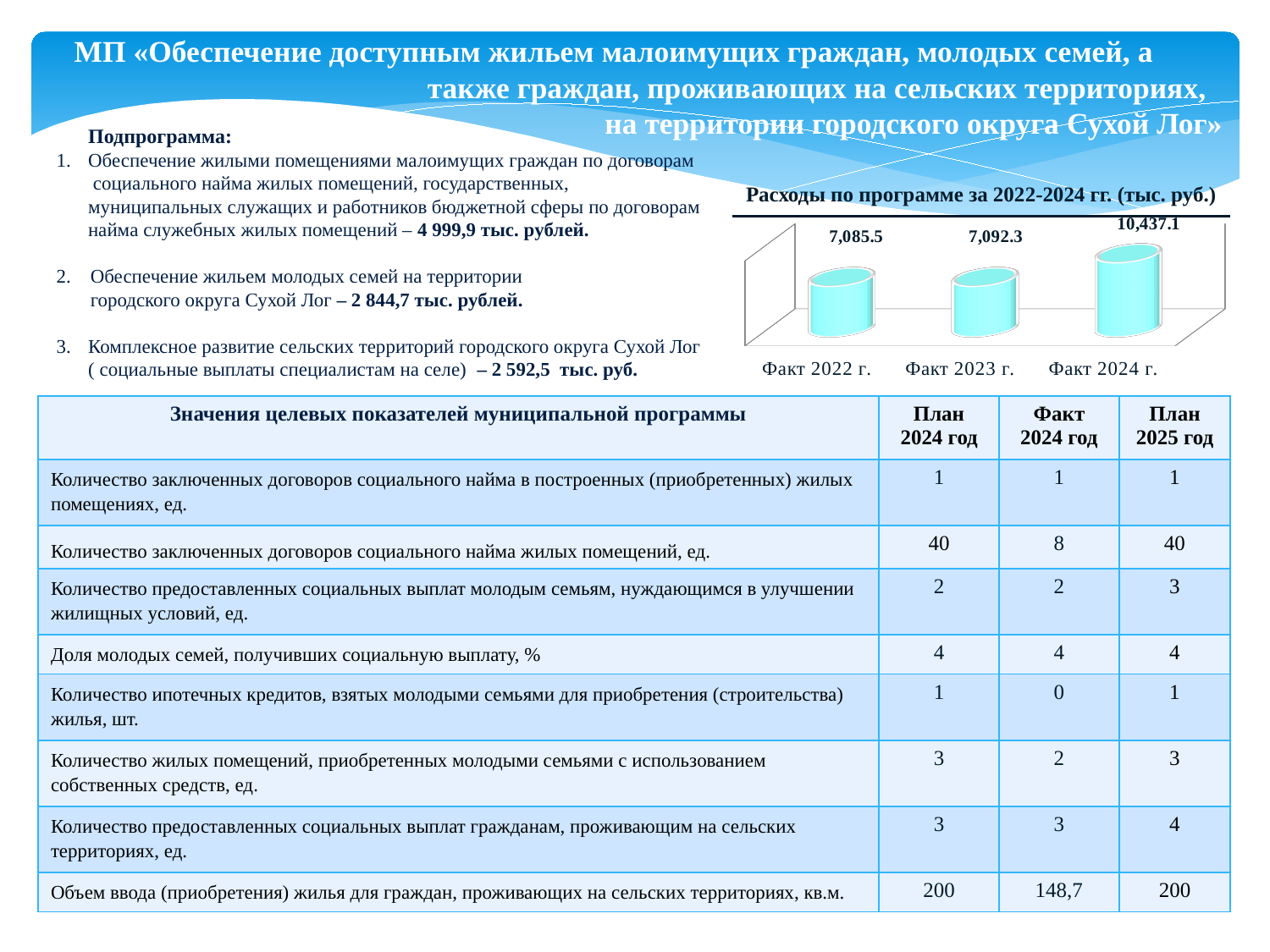
What is the value for Факт 2023 г. in the chart «Расходы по программе за 2022-2024 гг. (тыс. руб.)»? 7,092.3 Which category has the lowest value in the chart «Расходы по программе за 2022-2024 гг. (тыс. руб.)»? Факт 2022 г. Which category has the highest value in the chart «Расходы по программе за 2022-2024 гг. (тыс. руб.)»? Факт 2024 г. In what units are the values of the chart «Расходы по программе за 2022-2024 гг.» given, according to its title? тыс. руб. How many categories are shown in the chart «Расходы по программе за 2022-2024 гг. (тыс. руб.)»? 3 In the chart «Расходы по программе за 2022-2024 гг. (тыс. руб.)», what is the difference between the values for Факт 2024 г. and Факт 2022 г.? 3,351.6 Do the values in the chart «Расходы по программе за 2022-2024 гг. (тыс. руб.)» rise or fall from Факт 2022 г. to Факт 2024 г.? Rise What kind of chart is «Расходы по программе за 2022-2024 гг. (тыс. руб.)»? Bar chart What is the value for Факт 2022 г. in the chart «Расходы по программе за 2022-2024 гг. (тыс. руб.)»? 7,085.5 In the chart «Расходы по программе за 2022-2024 гг. (тыс. руб.)», what is the difference between the values for Факт 2024 г. and Факт 2023 г.? 3,344.8 What is the value for Факт 2024 г. in the chart «Расходы по программе за 2022-2024 гг. (тыс. руб.)»? 10,437.1 In the chart «Расходы по программе за 2022-2024 гг. (тыс. руб.)», which is larger: the value for Факт 2024 г. or Факт 2022 г.? Факт 2024 г.